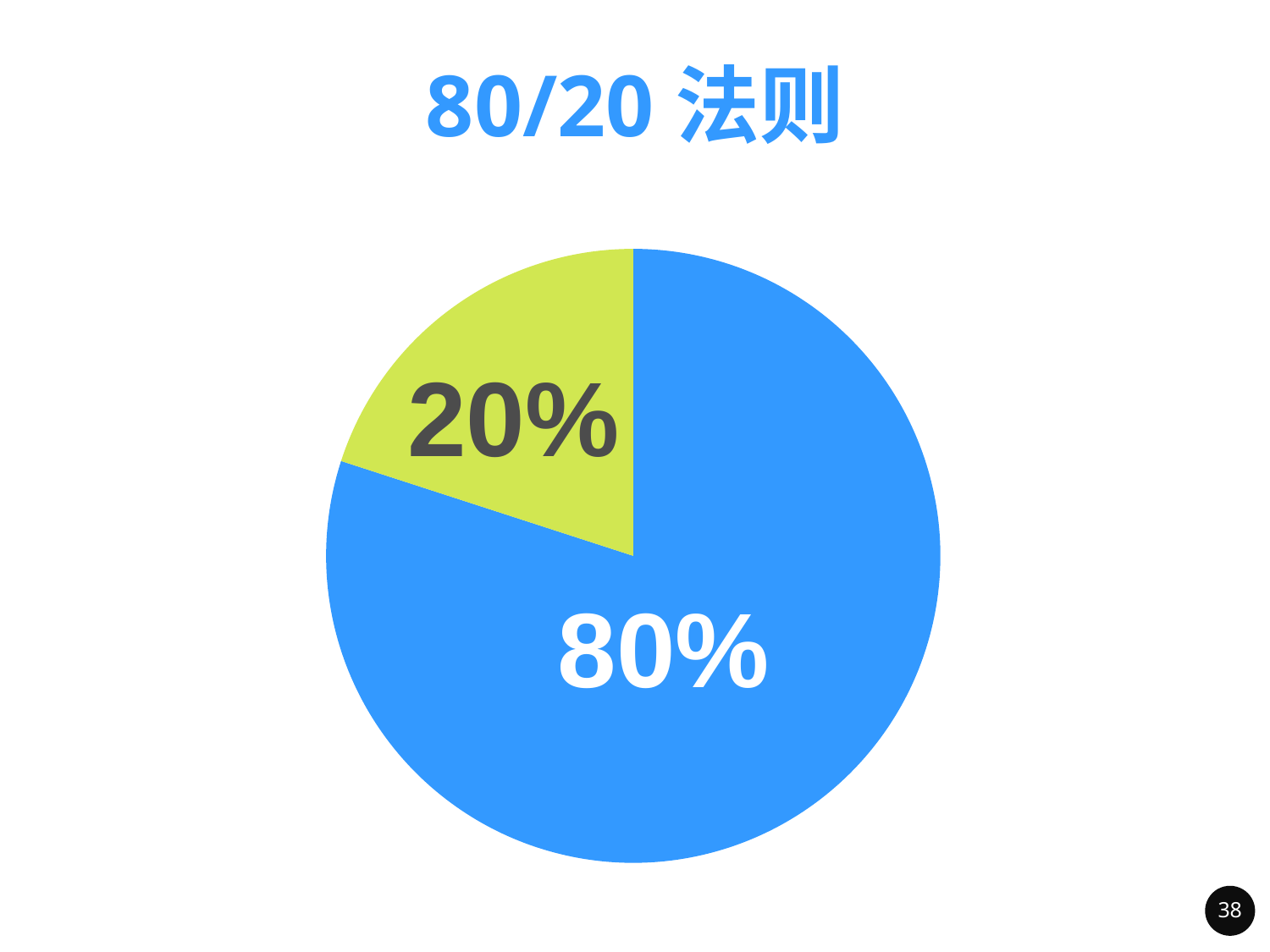
What is the difference between the blue slice and the green slice in the pie chart? 60% Which slice of the pie chart is the largest? the blue slice (80%) What is the total of the two slices shown in the pie chart? 100% What percentage is shown on the blue slice of the pie chart? 80% Which is larger in the pie chart, the blue slice or the green slice? the blue slice What share of the pie does the green slice represent? 20% How many slices does the pie chart have? 2 What colour is the slice labelled 80%? blue What is the title of the slide? 80/20 法则 Which slice of the pie chart is the smallest? the green slice (20%) What percentage is shown on the green slice of the pie chart? 20% What kind of chart is shown on the slide? pie chart